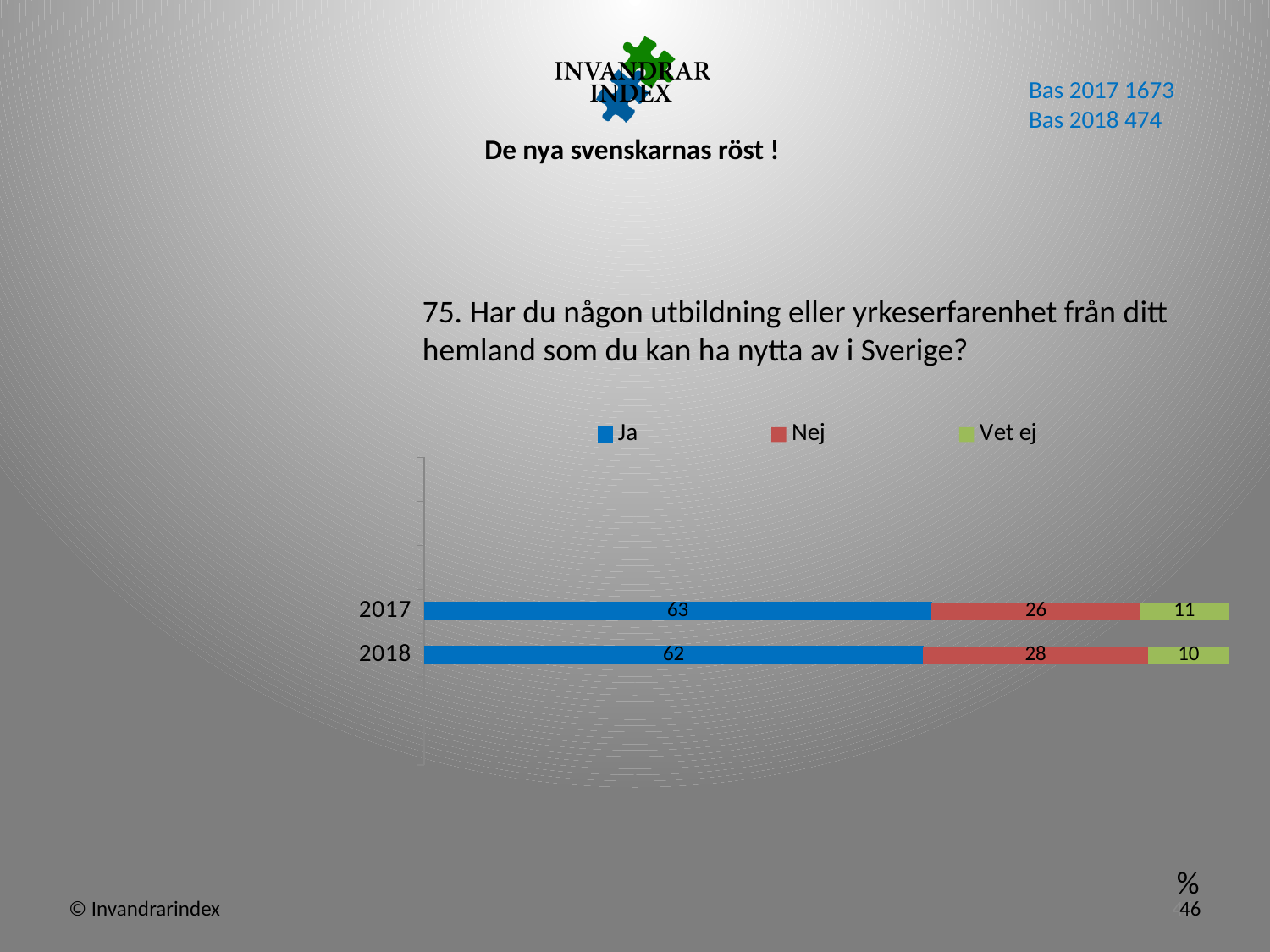
What is the value for Ja in 2018? 62 How many series does the legend list? 3 What is the total of the stacked bar for 2017? 100 What kind of chart is shown? Stacked bar chart Which year has the lower value for Vet ej? 2018 What is the difference between the Nej values for 2018 and 2017? 2 What is the value for Vet ej in 2017? 11 What is the value for Nej in 2018? 28 Is the value for Ja in 2017 larger than the value for Ja in 2018? Yes How many years are shown on the chart? 2 What is the value for Ja in 2017? 63 Which year has the higher value for Nej? 2018